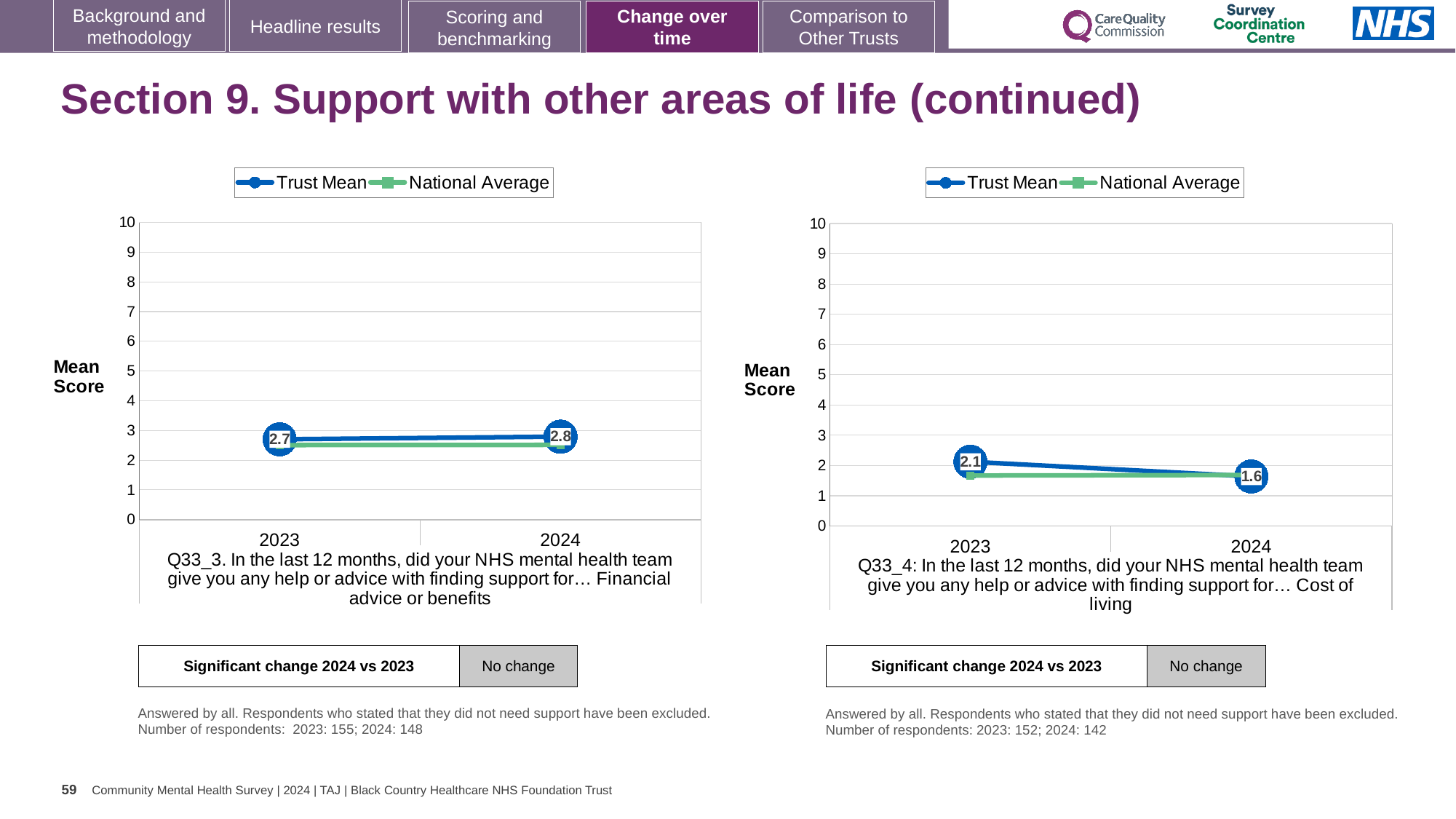
How many series does the legend of the left chart list? 2 In the left chart (Q33_3, Financial advice or benefits), what is the Trust Mean for 2024? 2.8 What kind of chart is the right chart (Q33_4, Cost of living)? line chart In the right chart (Q33_4, Cost of living), which year has the higher Trust Mean, 2023 or 2024? 2023 How many years are plotted on the x axis of the left chart (Q33_3)? 2 In the left chart (Q33_3, Financial advice or benefits), is the National Average for 2024 greater or less than 5? less In the right chart (Q33_4, Cost of living), what is the Trust Mean for 2023? 2.1 In the right chart (Q33_4, Cost of living), what is the Trust Mean for 2024? 1.6 In the left chart (Q33_3, Financial advice or benefits), what is the difference between the Trust Mean in 2024 and in 2023? 0.1 In the left chart (Q33_3, Financial advice or benefits), what is the Trust Mean for 2023? 2.7 In the right chart (Q33_4, Cost of living), by how much did the Trust Mean change from 2023 to 2024? 0.5 In the right chart (Q33_4, Cost of living), does the Trust Mean rise or fall from 2023 to 2024? fall